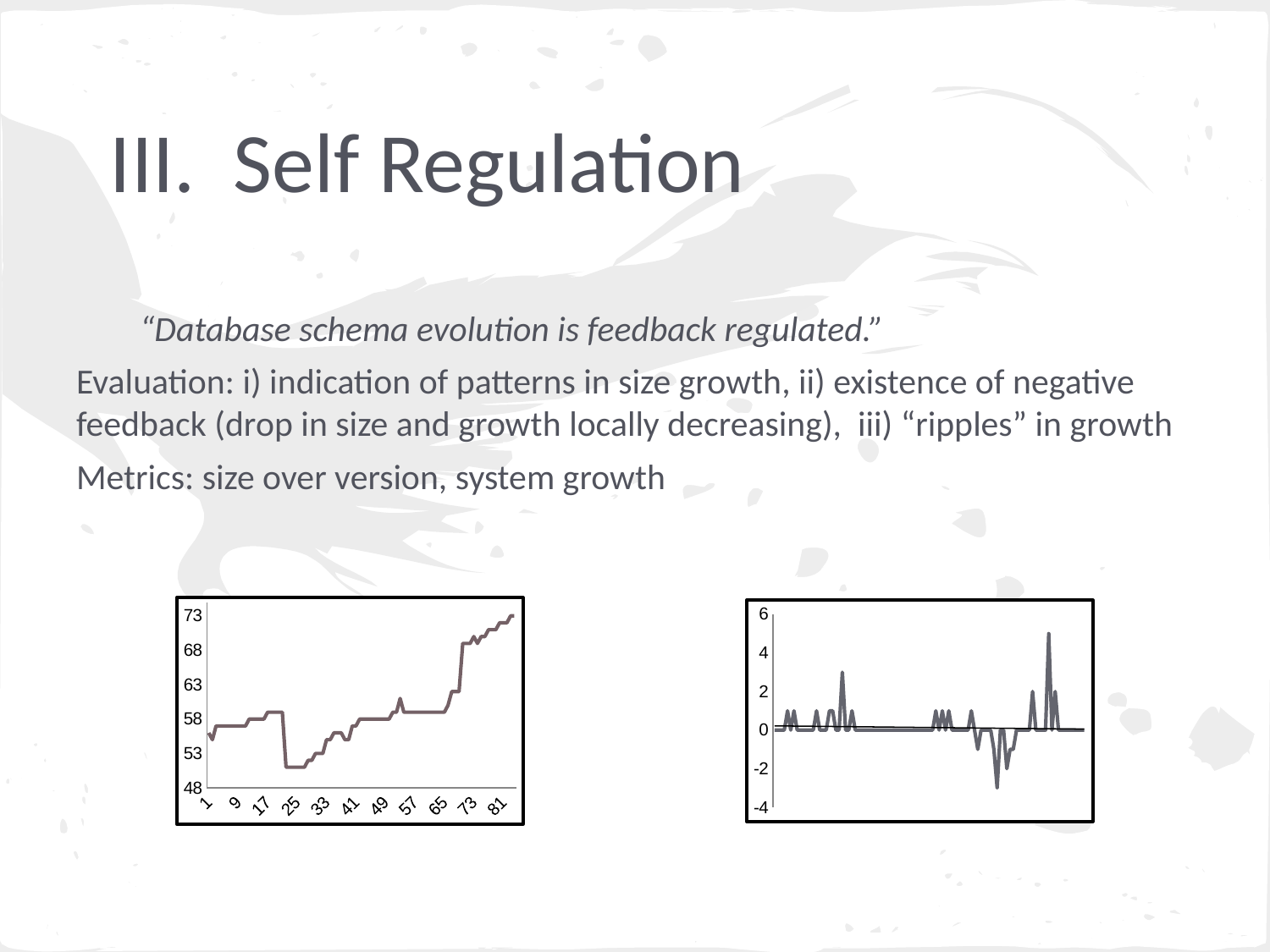
In the chart on the right, is the lowest dip greater or less than -2? less In the chart on the left, do the values overall rise or fall from version 1 to version 81? rise In the chart on the left, is the value at version 65 greater or less than 63? less What is the lowest value shown on the y axis of the chart on the left? 48 In the chart on the right, is the highest peak greater or less than 4? greater What kind of chart is the chart on the left of the slide? line chart What kind of chart is the chart on the right of the slide? line chart What is the highest value shown on the y axis of the chart on the right? 6